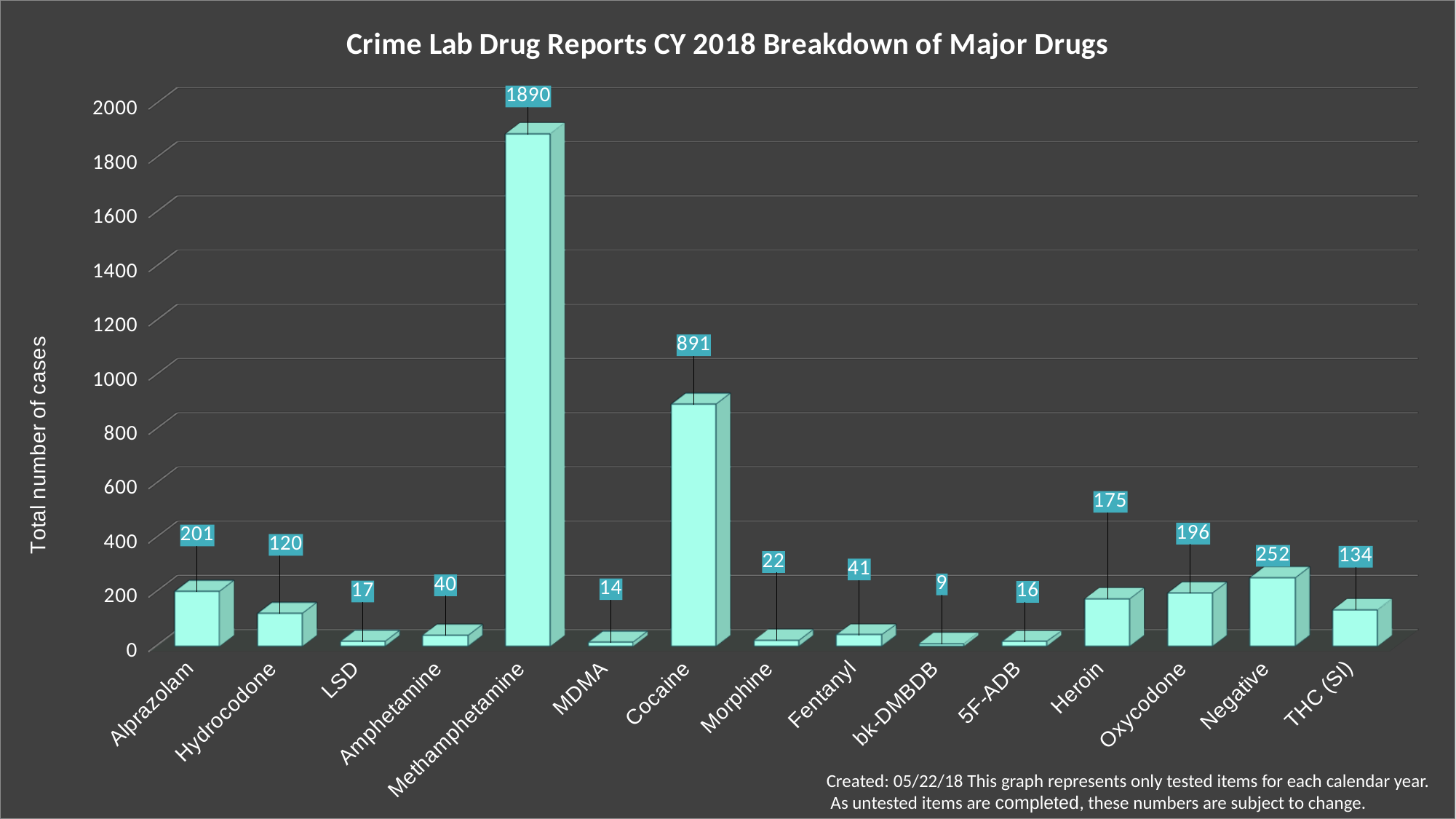
Which drug has the highest number of cases? Methamphetamine What is the value for Cocaine? 891 What is the value for Methamphetamine? 1890 What is the difference between the values for Methamphetamine and Cocaine? 999 Which drug has the lowest number of cases? bk-DMBDB Is the value for Cocaine greater or less than 800? greater What kind of chart is shown on the slide? Bar chart What is the difference between the values for Negative and Alprazolam? 51 Which is larger, the value for Oxycodone or the value for Heroin? Oxycodone What is the value for Heroin? 175 What is the title of the chart? Crime Lab Drug Reports CY 2018 Breakdown of Major Drugs How many drug categories are shown on the x axis? 15